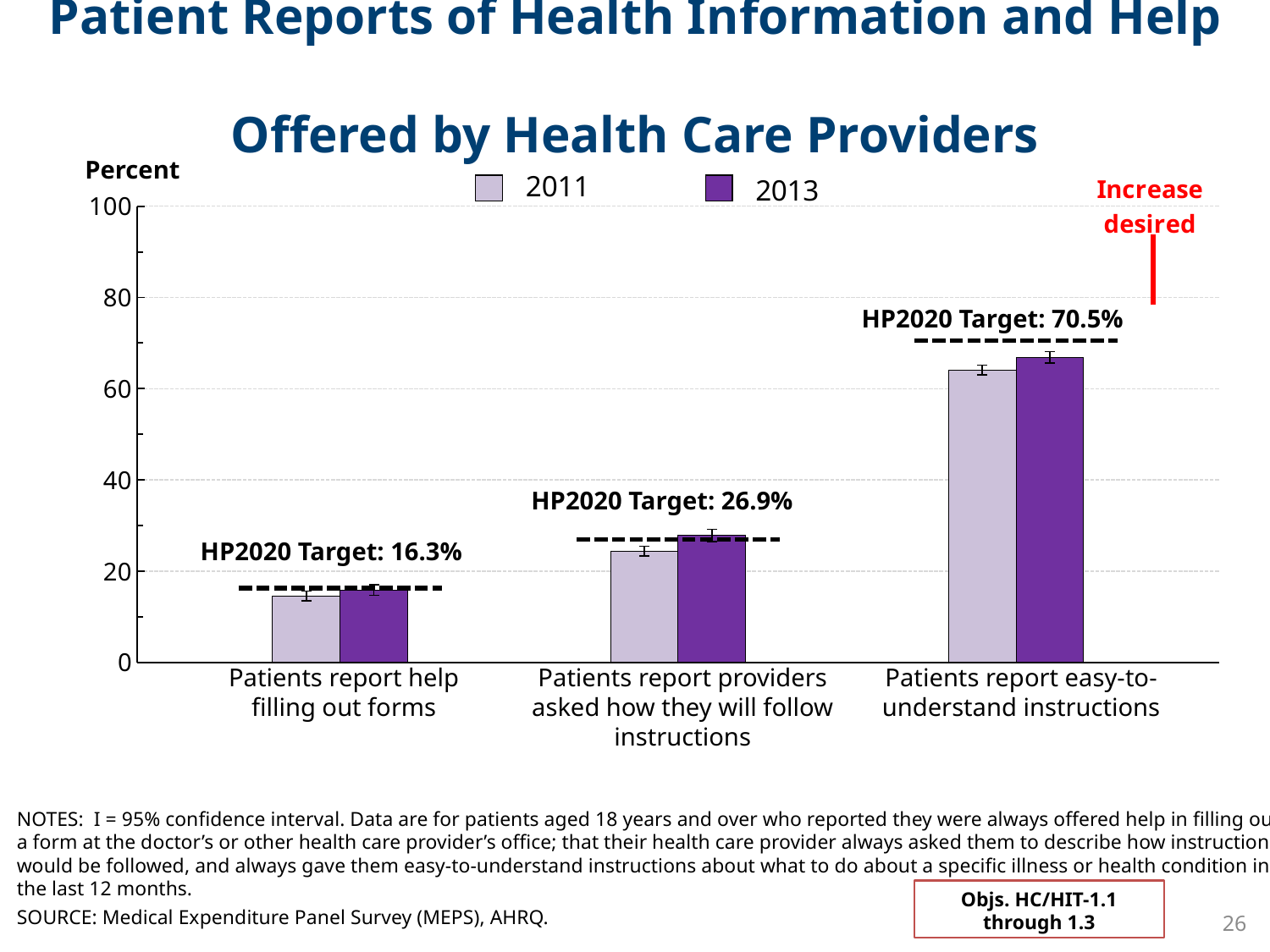
What is the HP2020 Target shown for 'Patients report easy-to-understand instructions'? 70.5% What is the HP2020 Target shown for 'Patients report providers asked how they will follow instructions'? 26.9% Is the 2013 value for 'Patients report easy-to-understand instructions' greater or less than 60? greater Is the 2011 value for 'Patients report help filling out forms' greater or less than 20? less For 'Patients report easy-to-understand instructions', which year has the larger value, 2011 or 2013? 2013 Which category has the lowest values? Patients report help filling out forms What kind of chart is shown on the slide? bar chart How many series does the legend list? 2 Which category has the highest values? Patients report easy-to-understand instructions How many categories are shown on the x axis? 3 What is the HP2020 Target shown for 'Patients report help filling out forms'? 16.3% Which years are listed in the legend? 2011 and 2013